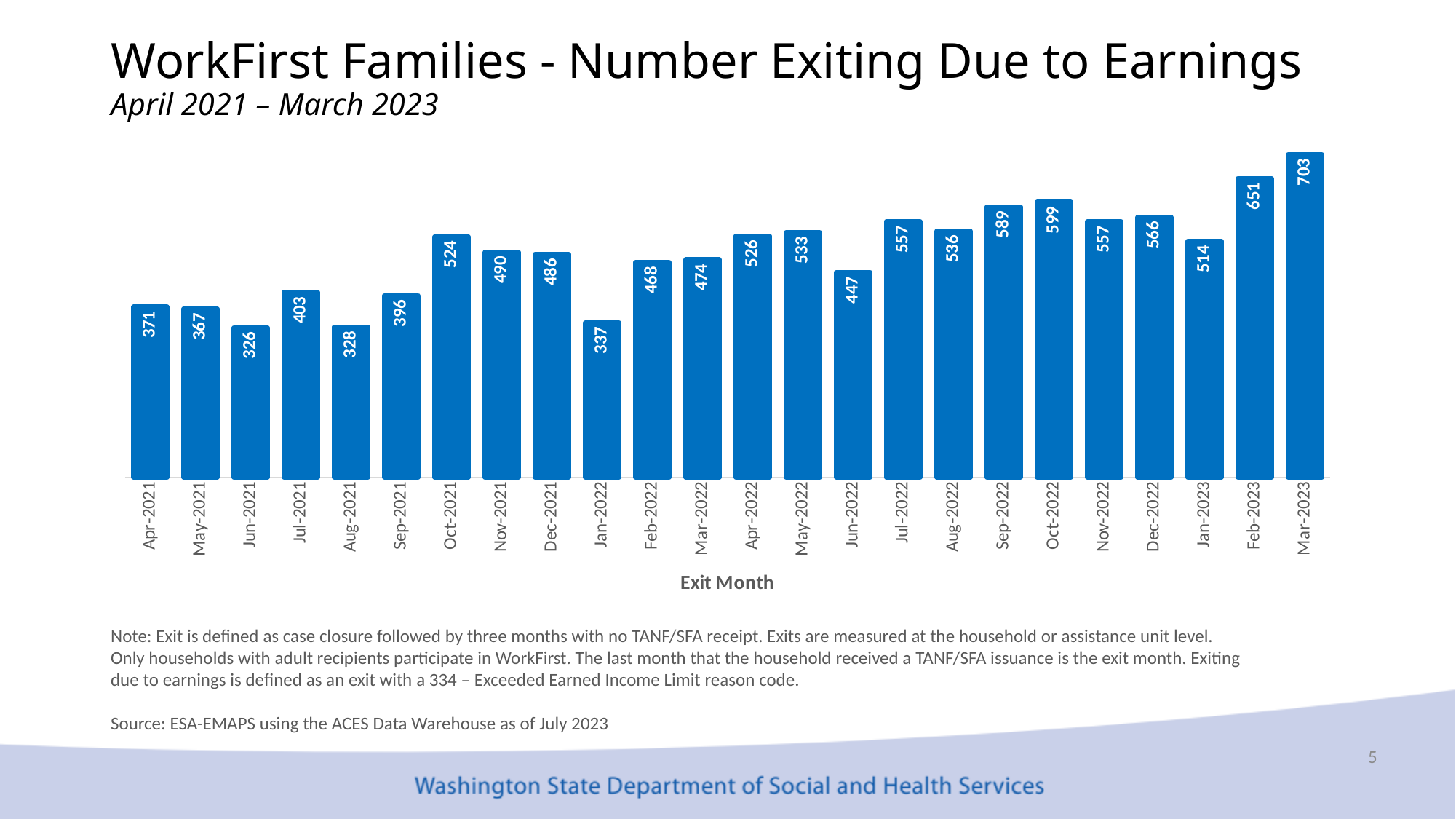
What is the x-axis title of the chart? Exit Month Which exit month has the highest number of families exiting due to earnings? Mar-2023 What is the number of WorkFirst families exiting due to earnings in Oct-2021? 524 What is the difference between the values for Mar-2023 and Feb-2023? 52 How many exit months are shown on the chart? 24 What is the difference between the values for Oct-2022 and Jan-2023? 85 Which is larger, the value for Sep-2022 or the value for Dec-2022? Sep-2022 Which is larger, the value for Nov-2021 or the value for Dec-2021? Nov-2021 What kind of chart is shown on the slide? Bar chart What is the value for Jan-2022? 337 Which exit month has the lowest number of families exiting due to earnings? Jun-2021 What is the value for Feb-2023? 651